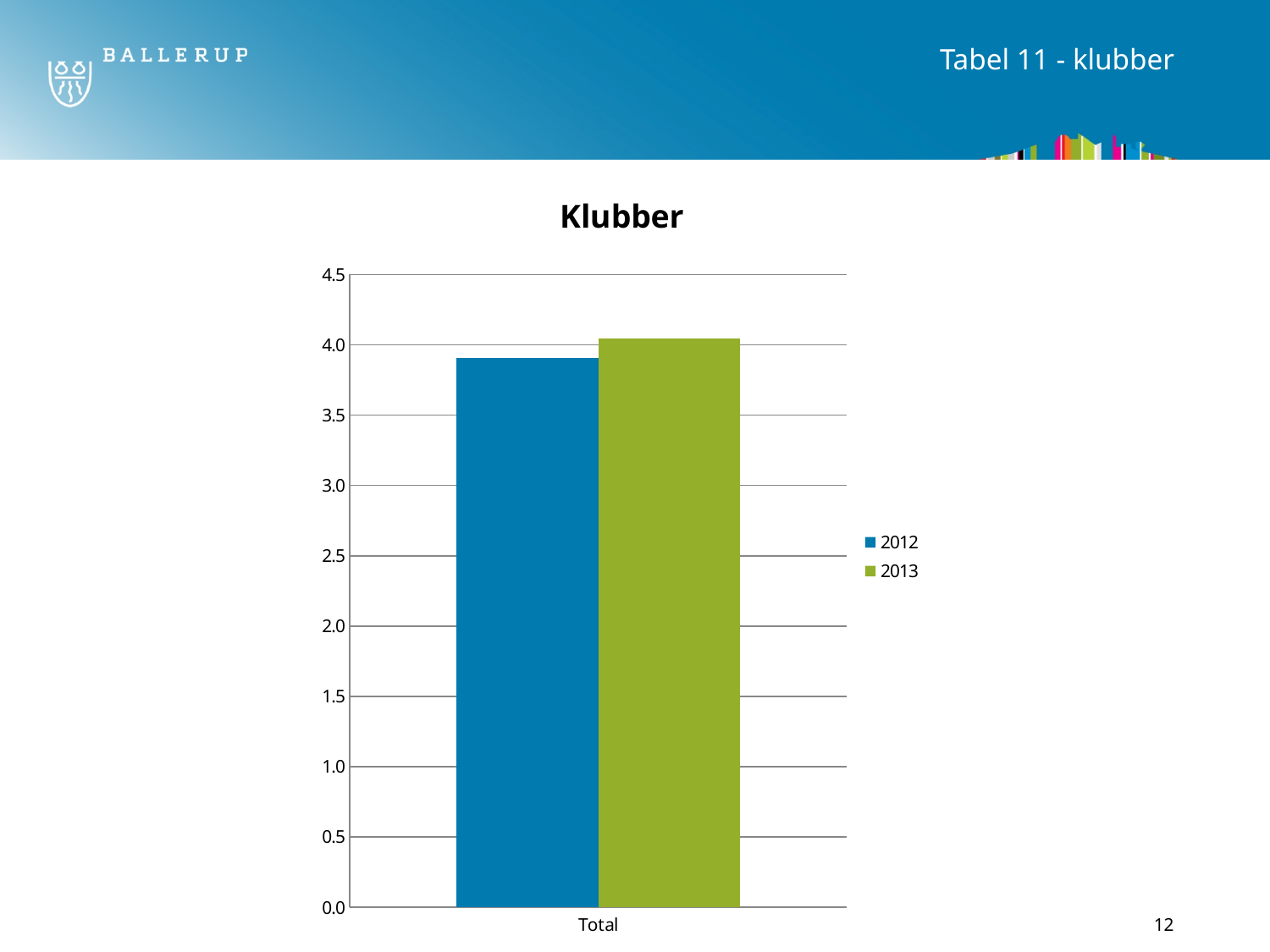
How many series does the legend list? 2 Which series has the taller bar for Total, 2012 or 2013? 2013 Is the value for 2012 greater or less than 3.5? greater Which series has the lowest value for Total? 2012 What is the title of the chart? Klubber What is the highest value shown on the y axis? 4.5 What kind of chart is shown on the slide? bar chart Is the value for 2013 greater or less than 3.5? greater Is the value for 2012 greater or less than 4.0? less What is the label of the category on the x axis? Total Which series are listed in the legend? 2012 and 2013 How many categories are shown on the x axis? 1